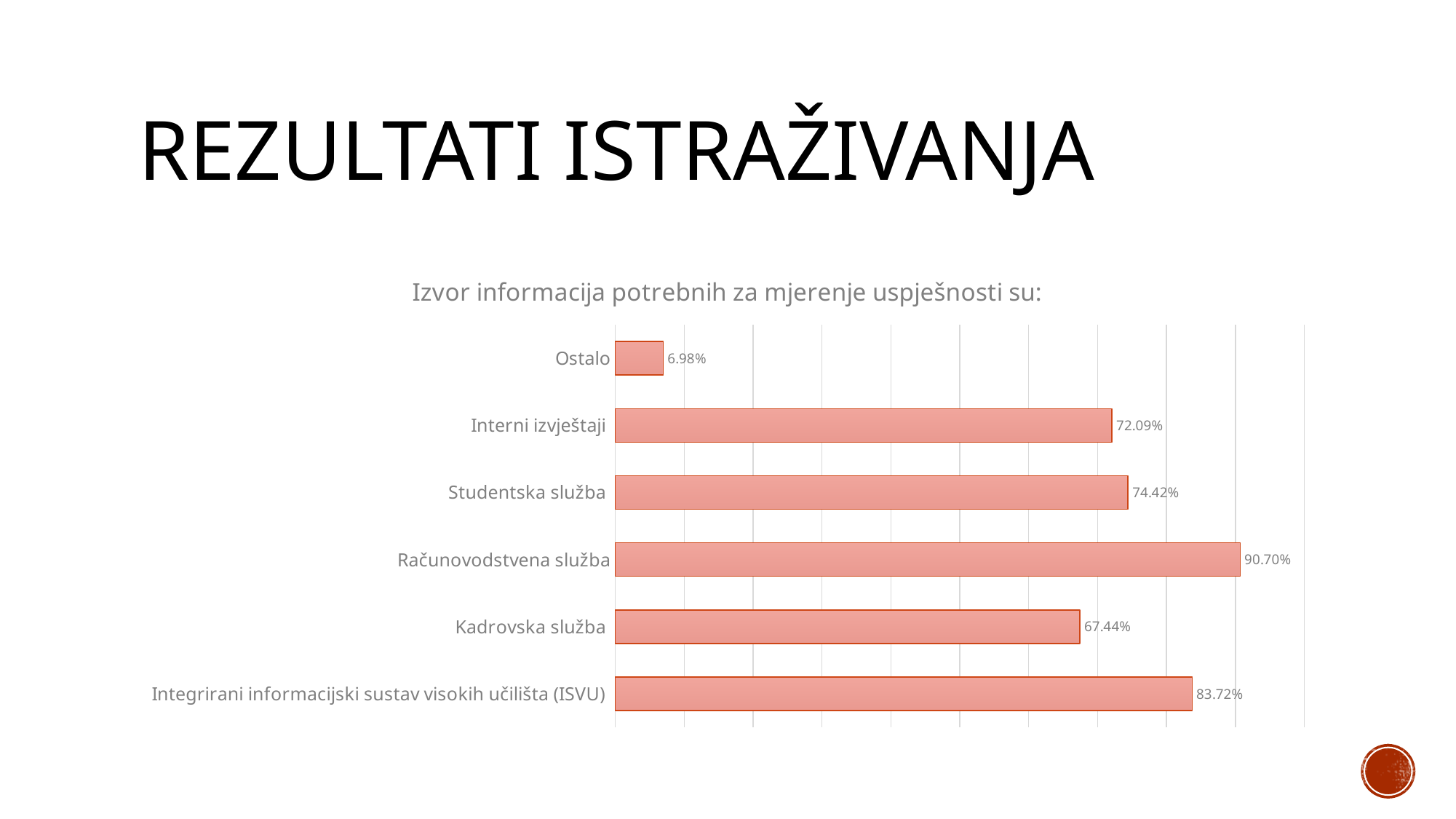
What is the title of the chart? Izvor informacija potrebnih za mjerenje uspješnosti su: Which category has the lowest value? Ostalo What is the value for Računovodstvena služba? 90.70% How many categories are shown in the chart? 6 What is the value for Integrirani informacijski sustav visokih učilišta (ISVU)? 83.72% What is the difference between the values for Računovodstvena služba and Kadrovska služba? 23.26% What is the value for Ostalo? 6.98% What kind of chart is shown on the slide? Bar chart What is the difference between the values for Studentska služba and Interni izvještaji? 2.33% Which category has the highest value? Računovodstvena služba What is the value for Kadrovska služba? 67.44% Which is larger, the value for Studentska služba or the value for Kadrovska služba? Studentska služba